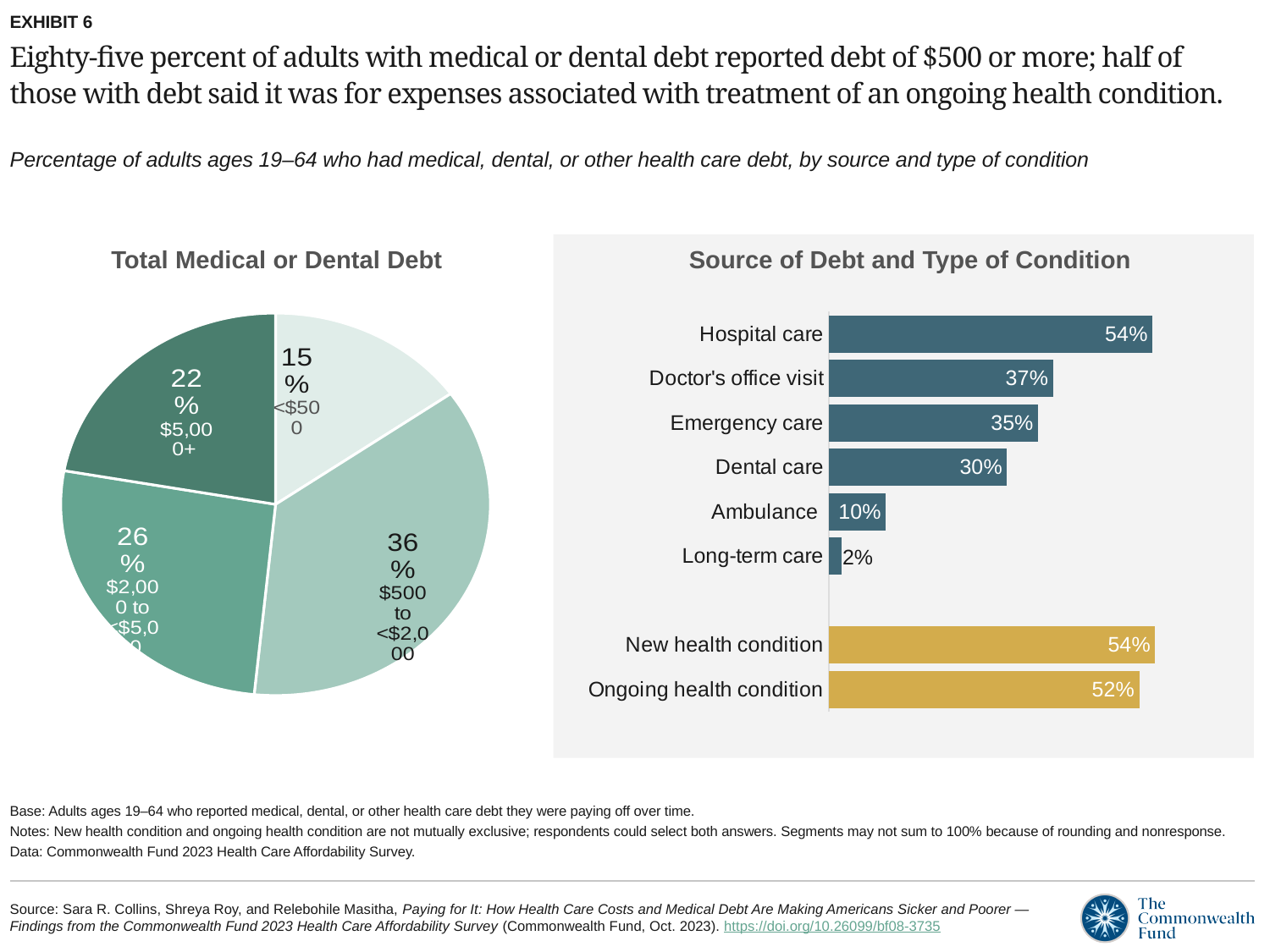
In the 'Source of Debt and Type of Condition' chart, how many bars are plotted? 8 In the 'Source of Debt and Type of Condition' chart, what percentage is shown for Hospital care? 54% In the 'Total Medical or Dental Debt' pie chart, what share of adults had debt of $5,000 or more? 22% In the 'Total Medical or Dental Debt' pie chart, which debt range has the smallest slice? <$500 In the 'Source of Debt and Type of Condition' chart, what is the difference between Doctor's office visit and Dental care? 7 percentage points What type of chart is 'Source of Debt and Type of Condition'? Bar chart In the 'Source of Debt and Type of Condition' chart, what colour are the bars for New health condition and Ongoing health condition? Gold/yellow In the 'Total Medical or Dental Debt' pie chart, how many slices are there? 4 In the 'Total Medical or Dental Debt' pie chart, which debt range has the largest slice? $500 to <$2,000 In the 'Source of Debt and Type of Condition' chart, which is larger: New health condition or Ongoing health condition? New health condition In the 'Source of Debt and Type of Condition' chart, which source of debt has the lowest percentage? Long-term care In the 'Source of Debt and Type of Condition' chart, what percentage is shown for Ambulance? 10%